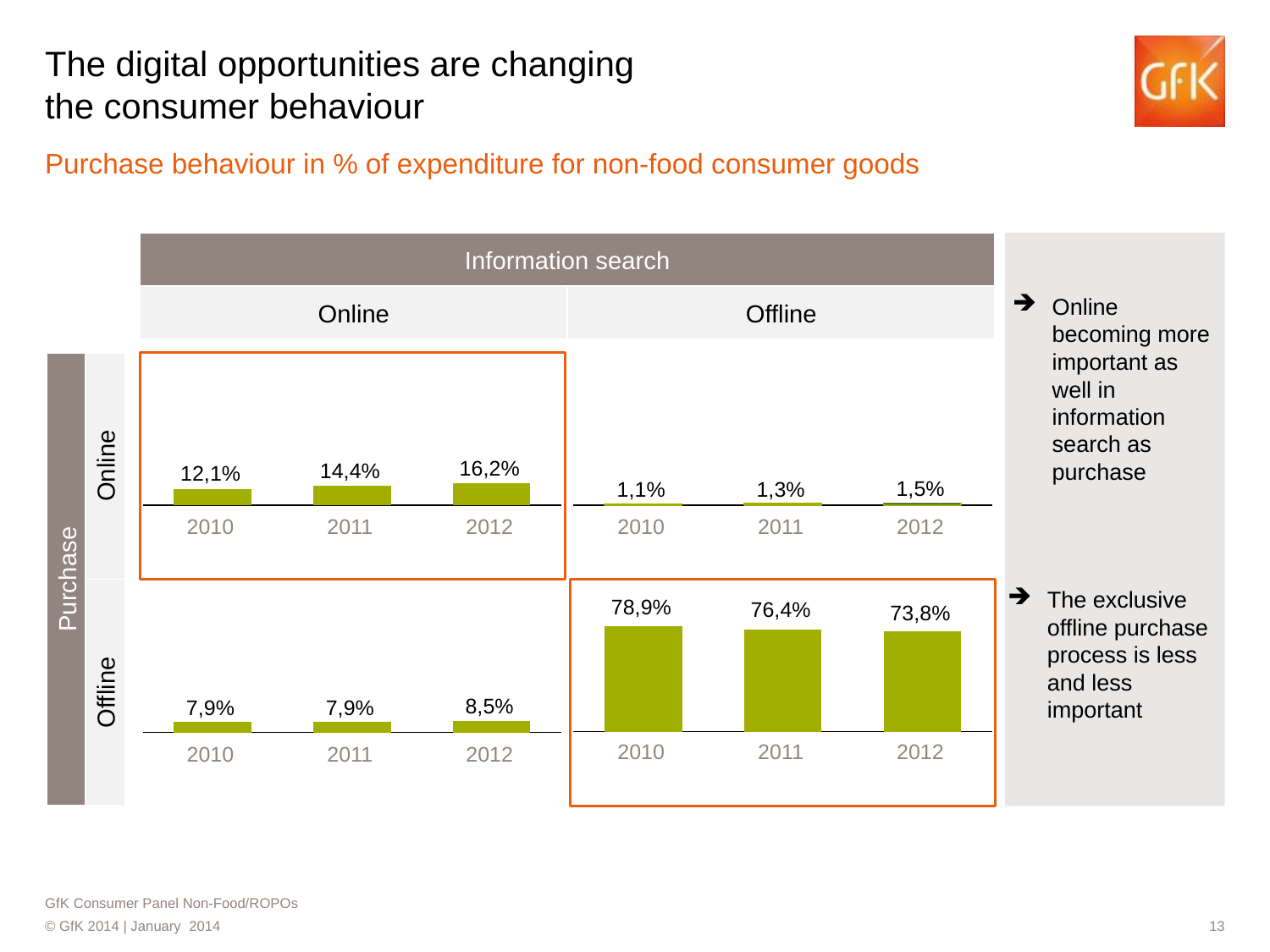
Do the values in the chart for online information search and online purchase (top-left) rise or fall from 2010 to 2012? rise In the chart for online information search and online purchase (top-left), which year has the highest value? 2012 How many years are shown in each of the charts on the slide? 3 In the chart for online information search and online purchase (top-left), what is the value for 2012? 16,2% In the chart for offline information search and offline purchase (bottom-right), which year has the lowest value? 2012 Do the values in the chart for offline information search and offline purchase (bottom-right) rise or fall from 2010 to 2012? fall In the chart for online information search and online purchase (top-left), what is the difference between the 2012 and 2010 values? 4,1 percentage points In the chart for offline information search and online purchase (top-right), what is the value for 2011? 1,3% In the chart for offline information search and offline purchase (bottom-right), what is the value for 2010? 78,9% What type of chart is used in the top-left panel (online information search, online purchase)? bar chart In the chart for online information search and offline purchase (bottom-left), what is the value for 2012? 8,5% In the chart for offline information search and offline purchase (bottom-right), what is the difference between the 2010 and 2012 values? 5,1 percentage points